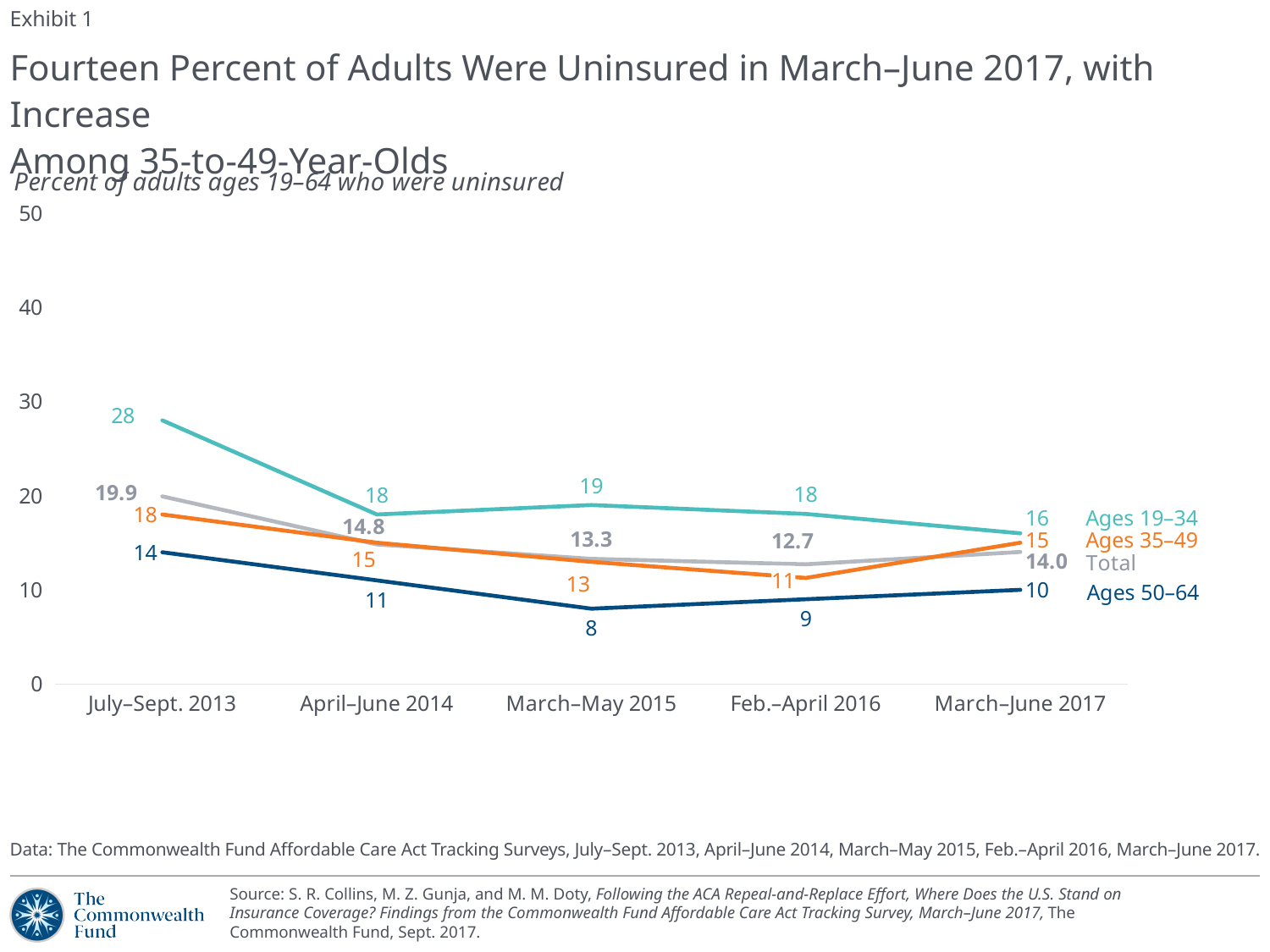
Did the uninsured rate for Ages 50–64 rise or fall from July–Sept. 2013 to March–May 2015? fall How many survey periods are shown on the x axis? 5 What was the uninsured rate for Ages 50–64 in March–May 2015? 8 What was the uninsured rate for Ages 35–49 in Feb.–April 2016? 11 What was the uninsured rate for Ages 19–34 in July–Sept. 2013? 28 Which was larger in April–June 2014: the uninsured rate for Ages 19–34 or for Ages 35–49? Ages 19–34 What was the Total uninsured rate in March–June 2017? 14.0 By how many percentage points did the uninsured rate for Ages 35–49 change from Feb.–April 2016 to March–June 2017? 4 Which age group had the highest uninsured rate in March–June 2017? Ages 19–34 In which survey period was the Total uninsured rate lowest? Feb.–April 2016 How many series are plotted on the chart? 4 What type of chart is shown on the slide? line chart